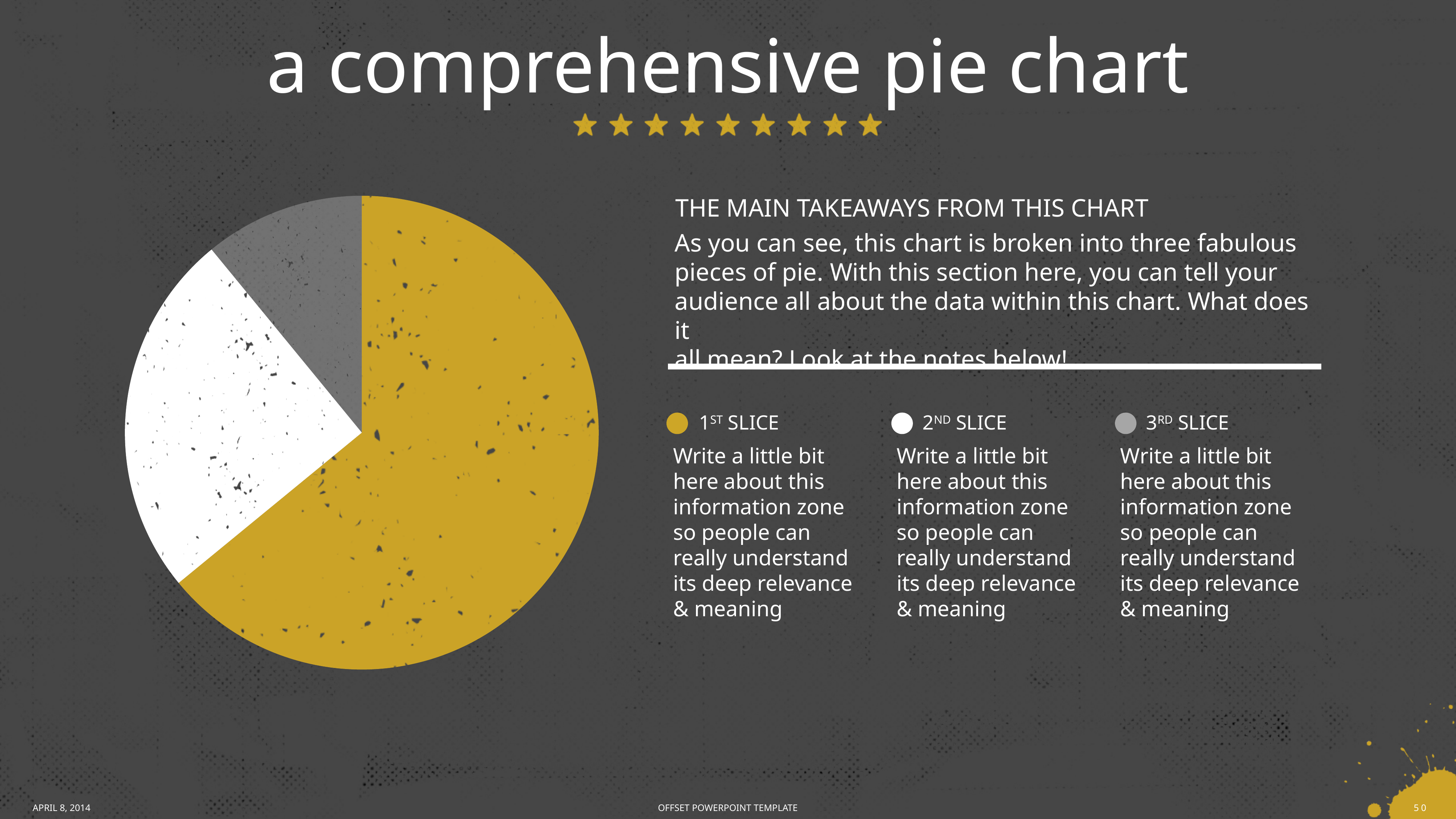
Which slice of the pie chart is the smallest? 3rd slice What kind of chart is shown on the slide? pie chart How many slices does the pie chart have? 3 Which is smaller in the pie chart, the 1st slice or the 3rd slice? 3rd slice Which slice of the pie chart is the largest? 1st slice Which is larger in the pie chart, the 2nd slice or the 3rd slice? 2nd slice What colour is the 3rd slice in the pie chart? grey How many entries does the legend list for the pie chart? 3 What colour is the 1st slice in the pie chart? gold Which is larger in the pie chart, the 1st slice or the 2nd slice? 1st slice